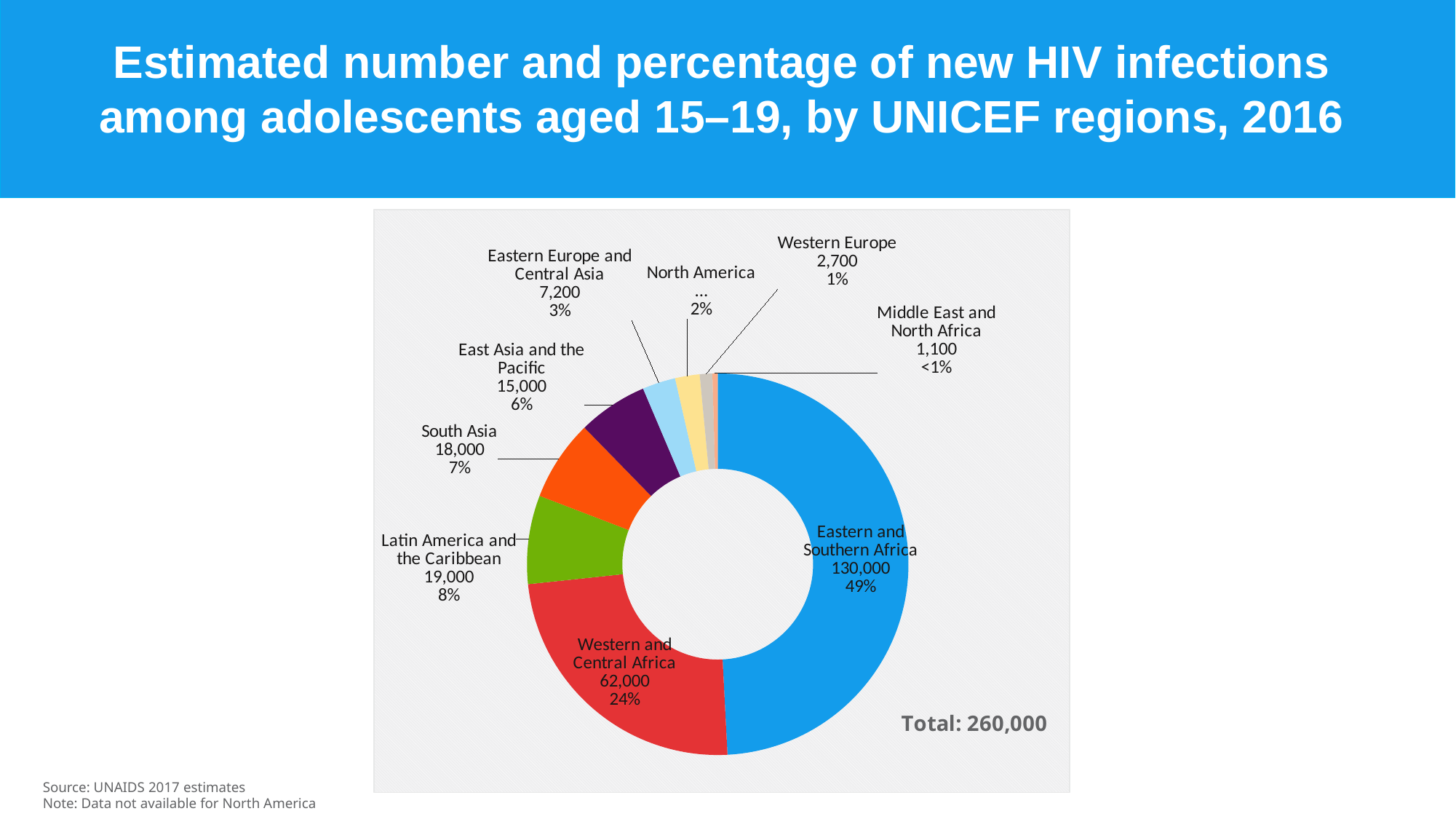
What kind of chart is shown on the slide? Doughnut (pie) chart What percentage of new HIV infections among adolescents aged 15–19 is attributed to Western and Central Africa? 24% Which region has the largest share of new HIV infections among adolescents aged 15–19? Eastern and Southern Africa What is the total estimated number of new HIV infections among adolescents aged 15–19 shown on the chart? 260,000 Which region has the smallest estimated number of new HIV infections among adolescents aged 15–19? Middle East and North Africa What is the estimated number of new HIV infections among adolescents aged 15–19 in Western Europe? 2,700 Which region has more estimated new HIV infections: East Asia and the Pacific or Eastern Europe and Central Asia? East Asia and the Pacific According to the note on the slide, for which region is data not available? North America What is the difference between the estimated number of new HIV infections in Latin America and the Caribbean and in South Asia? 1,000 How many regions are shown as slices in the chart? 9 What percentage of new HIV infections among adolescents aged 15–19 is attributed to the Middle East and North Africa? <1% What is the estimated number of new HIV infections among adolescents aged 15–19 in Eastern and Southern Africa? 130,000